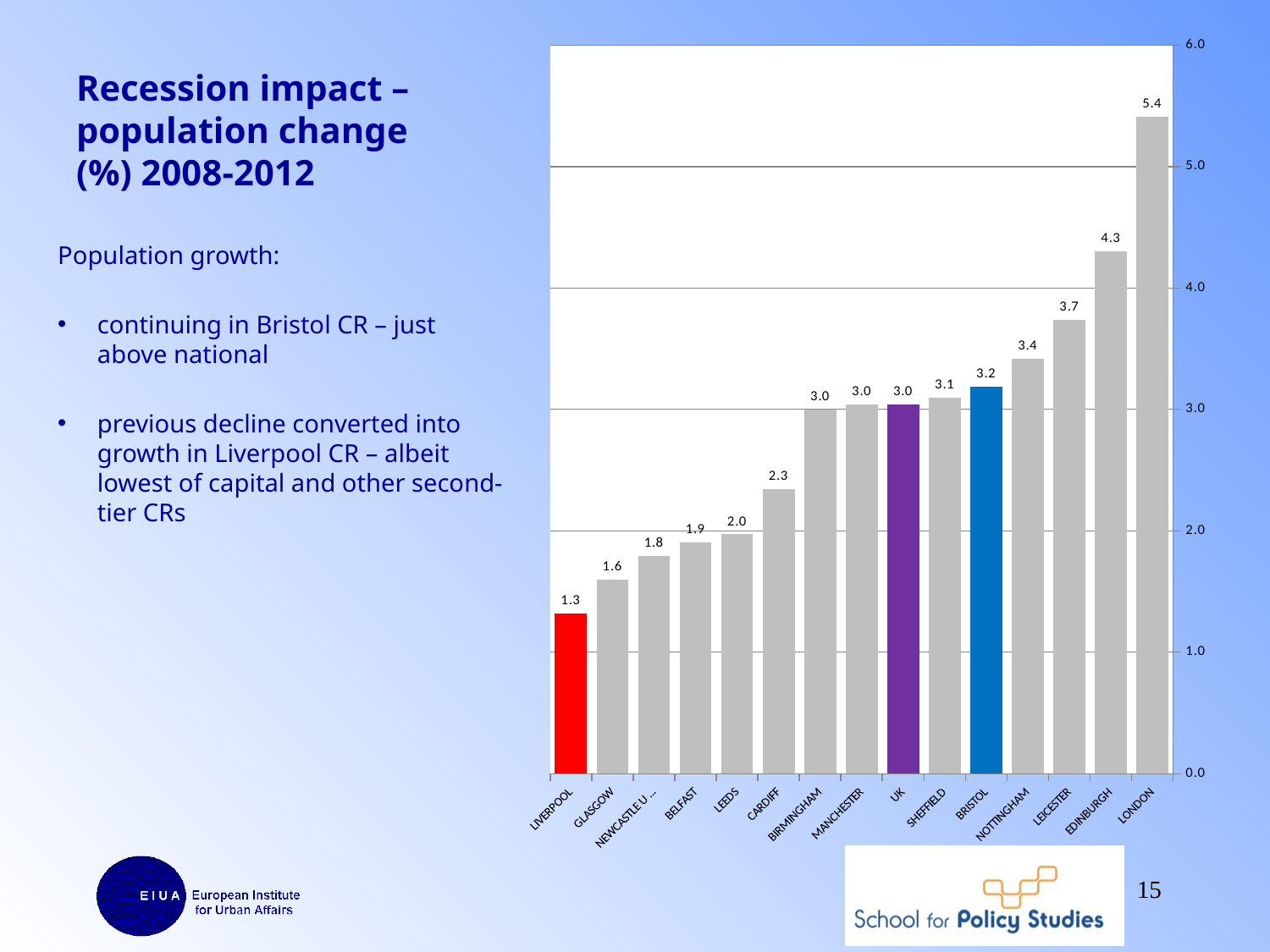
What is the value for London? 5.4 Which is larger, the value for Nottingham or the value for Sheffield? Nottingham What is the value for the UK bar? 3.0 What is the value for Liverpool? 1.3 What is the difference between the values for Bristol and Liverpool? 1.9 Which category has the highest value? London Do the values rise or fall from left to right along the x axis? Rise What is the difference between the values for London and Edinburgh? 1.1 What kind of chart is shown on the slide? Bar chart What is the value for Bristol? 3.2 How many categories are shown on the x axis? 15 Which category has the lowest value? Liverpool